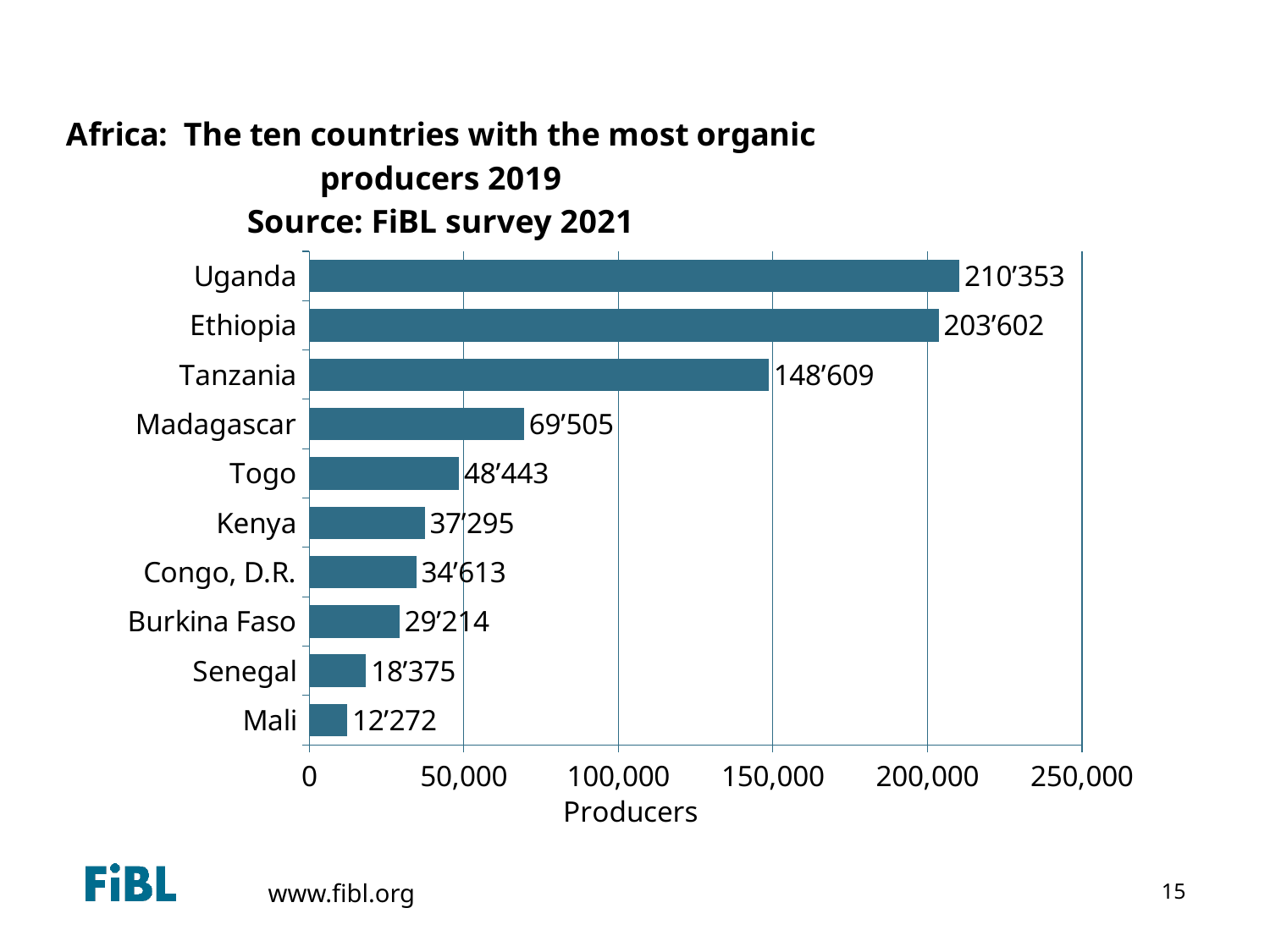
Which country has the fewest organic producers? Mali What is the difference in producers between Uganda and Ethiopia? 6’751 What is the label of the horizontal axis? Producers How many countries are shown in the chart? 10 What is the difference between Tanzania and Madagascar? 79’104 How many organic producers does Uganda have? 210’353 What is the number of producers shown for Senegal? 18’375 Which country has the most organic producers? Uganda What is the value for Madagascar? 69’505 Is the value for Tanzania greater or less than 150,000? less Which has more producers, Kenya or Togo? Togo What kind of chart is this? bar chart